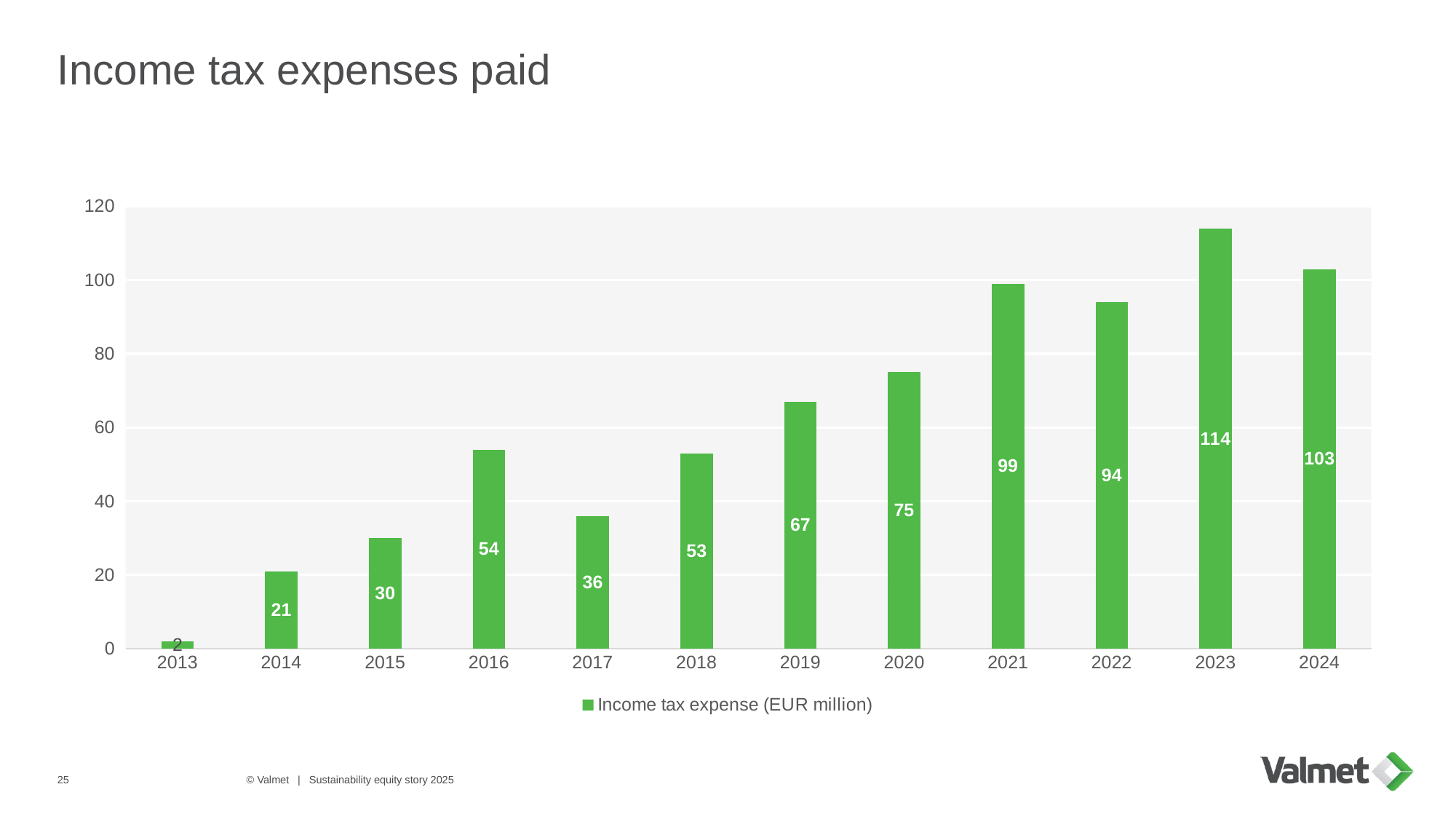
What is the income tax expense for 2013? 2 What type of chart is shown on the slide? Bar chart Which year has the lowest income tax expense? 2013 What is the difference between the income tax expense in 2023 and in 2024? 11 How many years are shown on the x axis? 12 What is the difference between the income tax expense in 2021 and in 2020? 24 What is the income tax expense for 2019? 67 What is the legend entry for the series shown? Income tax expense (EUR million) Is the value for 2017 greater or less than 40? less Which year has a larger income tax expense, 2016 or 2018? 2016 What is the income tax expense for 2022? 94 Which year has the highest income tax expense? 2023